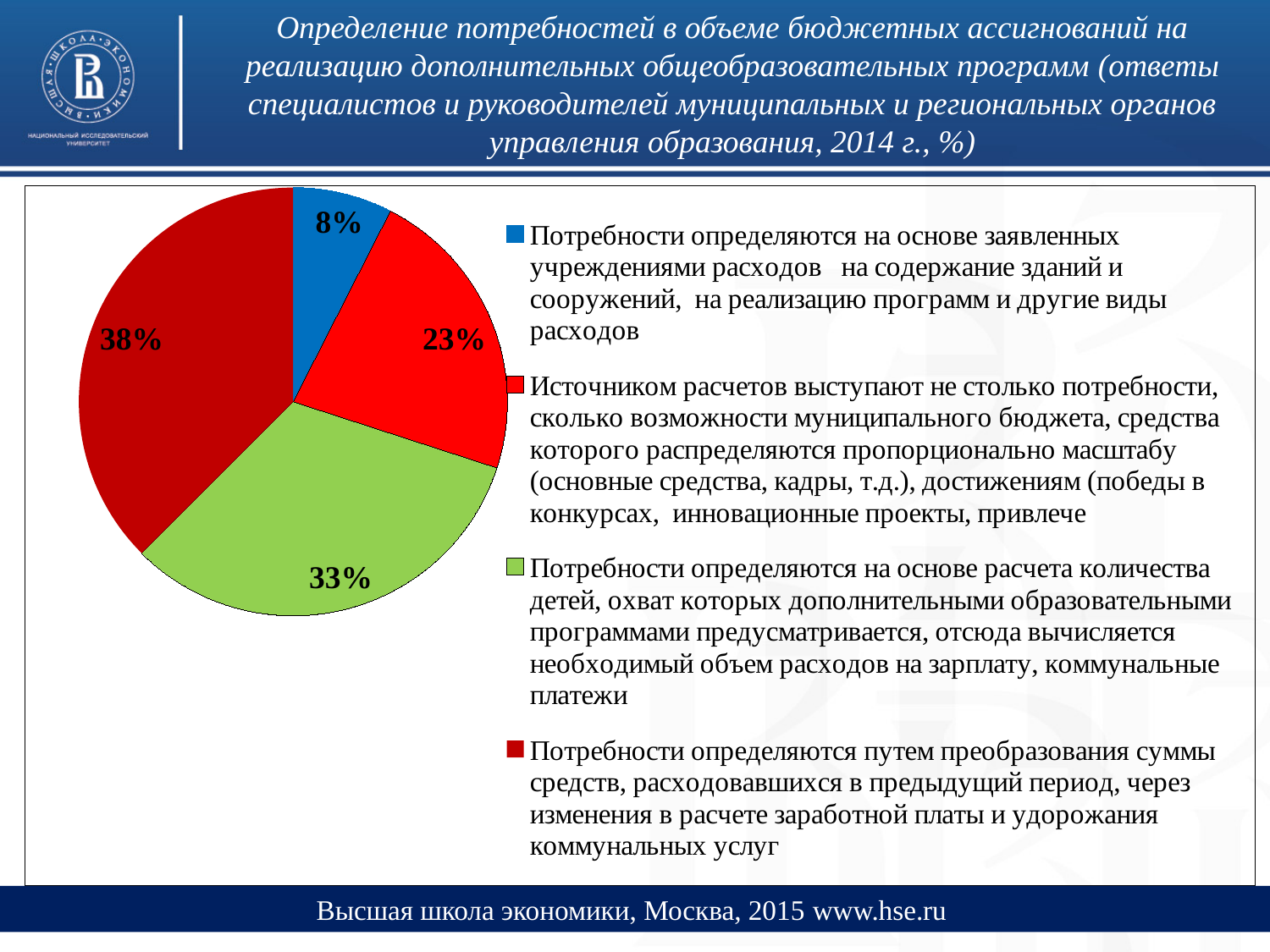
What share of the pie corresponds to the legend entry 'Потребности определяются на основе заявленных учреждениями расходов...' (blue slice)? 8% How many slices does the pie chart have? 4 What share of the pie corresponds to the legend entry 'Потребности определяются путем преобразования суммы средств, расходовавшихся в предыдущий период...' (dark red slice)? 38% What colour is the slice labelled 33%? green What share of the pie corresponds to the legend entry 'Потребности определяются на основе расчета количества детей...' (green slice)? 33% How many entries does the legend of the pie chart list? 4 What share of the pie corresponds to the legend entry 'Источником расчетов выступают не столько потребности, сколько возможности муниципального бюджета...' (red slice)? 23% Which slice of the pie chart is the largest? Потребности определяются путем преобразования суммы средств, расходовавшихся в предыдущий период (38%) Which slice of the pie chart is the smallest? Потребности определяются на основе заявленных учреждениями расходов (8%) What kind of chart is shown on the slide? pie chart What is the difference in percentage points between the largest slice (38%) and the smallest slice (8%)? 30 percentage points Which is larger: the share for 'Потребности определяются на основе расчета количества детей...' or the share for 'Источником расчетов выступают не столько потребности...'? Потребности определяются на основе расчета количества детей (33%)